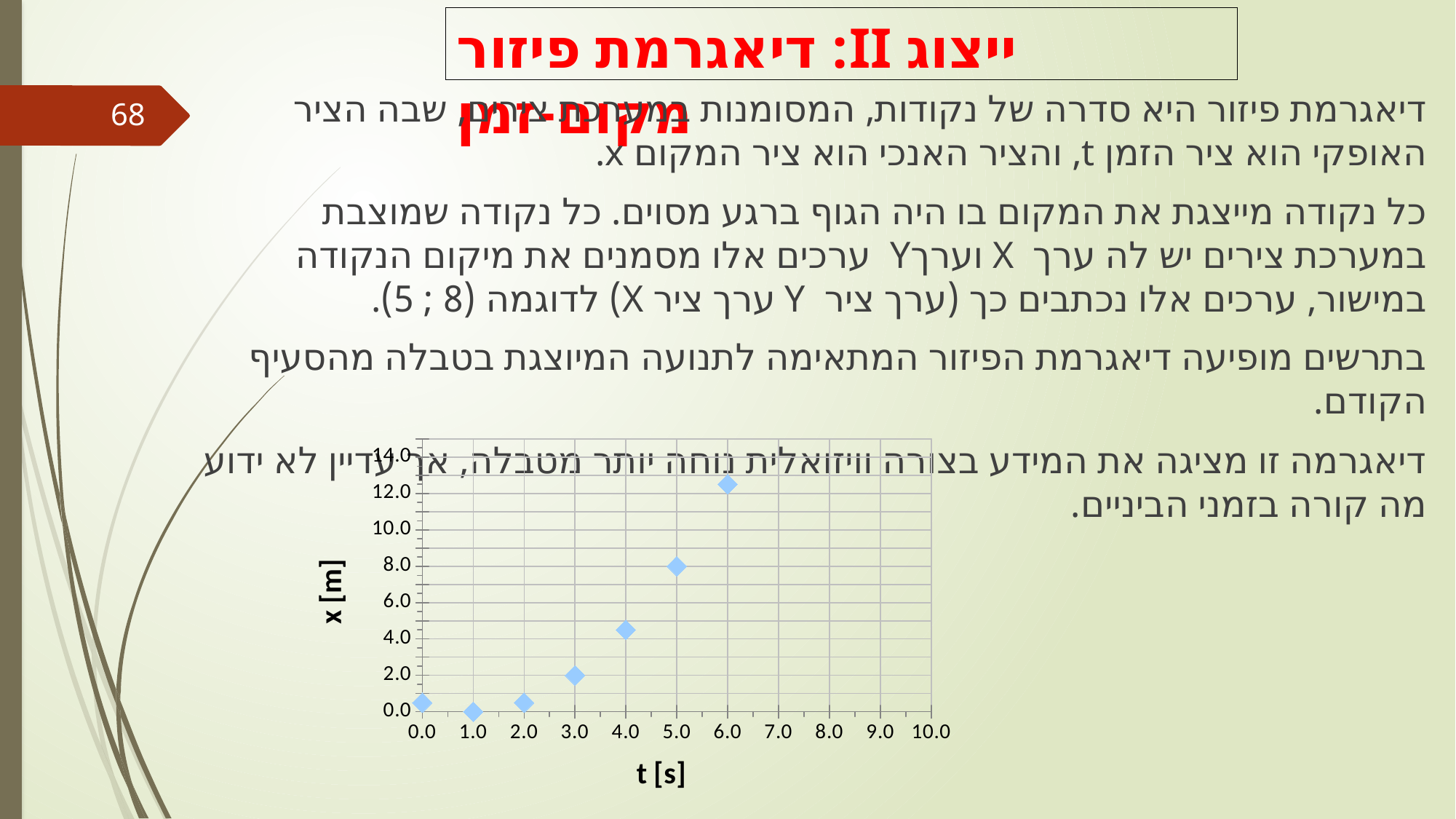
What is the label of the vertical axis of the chart? x [m] Is the value of x at t = 6.0 greater or less than 12.0? greater What is the difference between the value of x at t = 5.0 and at t = 3.0? 6.0 How many data points are plotted on the chart? 7 What kind of chart is shown on the slide? scatter chart Is the value of x at t = 2.0 greater or less than 2.0? less What is the value of x at t = 5.0? 8.0 What is the label of the horizontal axis of the chart? t [s] Which is larger, the value of x at t = 5.0 or at t = 3.0? t = 5.0 At which value of t is x the highest? 6.0 What is the value of x at t = 3.0? 2.0 Is the value of x at t = 4.0 greater or less than 6.0? less